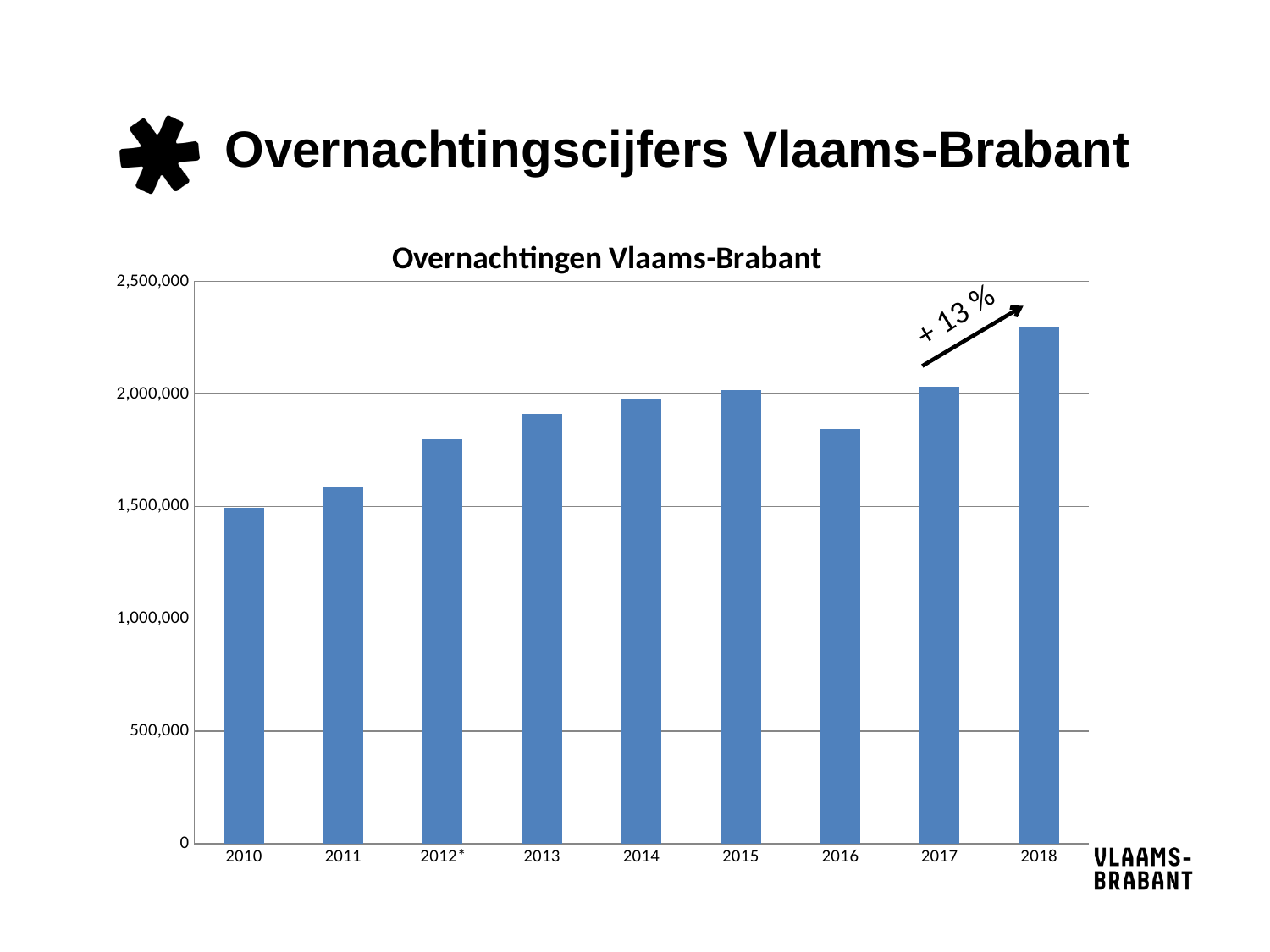
What type of chart is shown on the slide? bar chart Is the value for 2011 greater or less than 1,500,000? greater Is the value for 2016 greater or less than 2,000,000? less Is the value for 2018 greater or less than 2,000,000? greater What percentage change is annotated by the arrow between 2017 and 2018? + 13 % What is the title of the chart? Overnachtingen Vlaams-Brabant Which year has the highest number of overnight stays? 2018 How many years are shown on the x axis of the chart? 9 Which year has a higher value, 2016 or 2017? 2017 Which year has the lowest number of overnight stays? 2010 Which year has a higher value, 2012* or 2011? 2012*